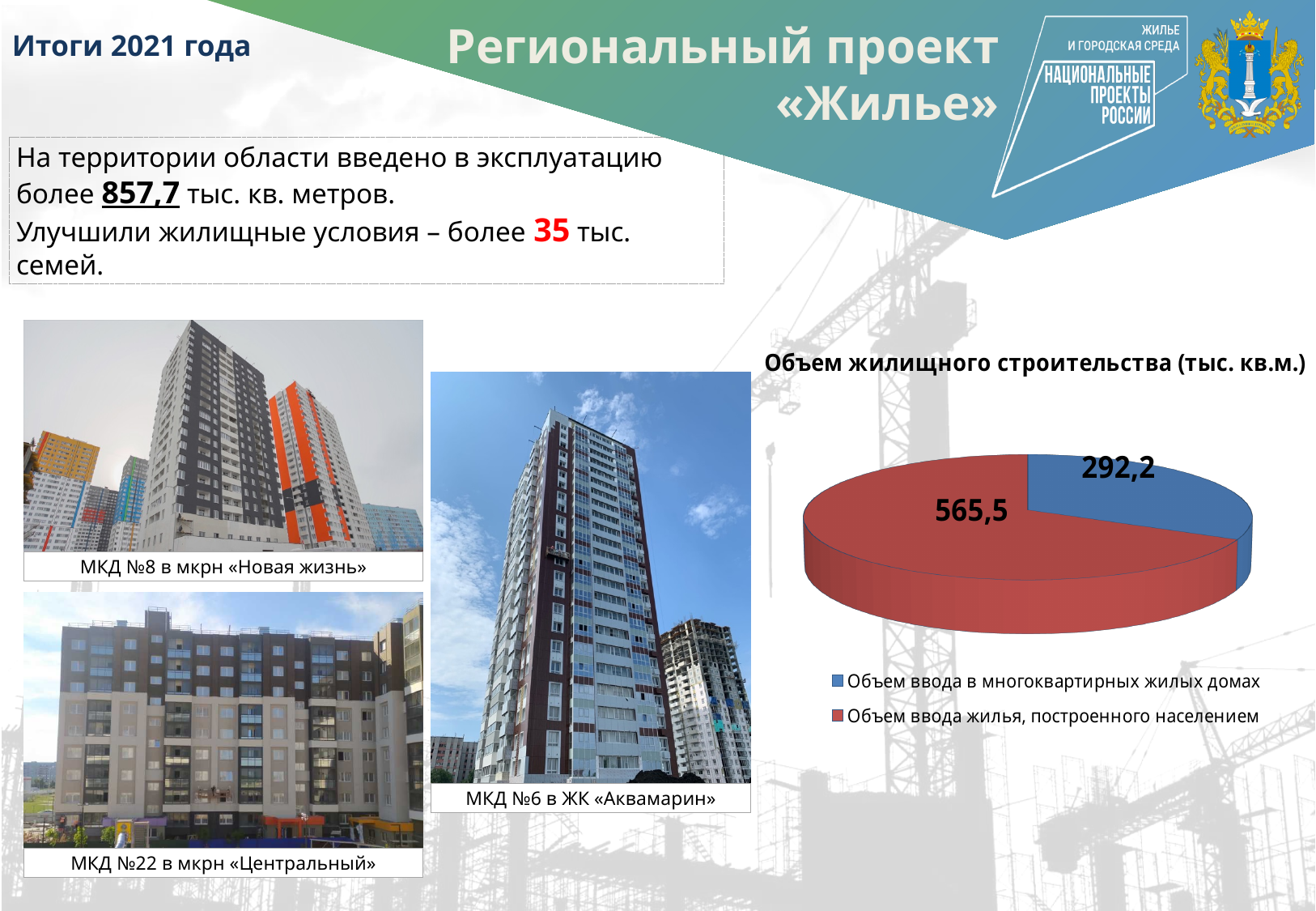
Which colour represents «Объем ввода жилья, построенного населением» in the pie chart? Red What is the total of the two values shown in the pie chart? 857,7 Which category has the smallest slice of the pie? Объем ввода в многоквартирных жилых домах What type of chart is shown on the slide? Pie chart How many entries does the chart legend list? 2 Which is larger: the value for «Объем ввода в многоквартирных жилых домах» or the value for «Объем ввода жилья, построенного населением»? Объем ввода жилья, построенного населением How many slices does the pie chart have? 2 What is the value for «Объем ввода жилья, построенного населением»? 565,5 Which category has the largest slice of the pie? Объем ввода жилья, построенного населением What is the value for «Объем ввода в многоквартирных жилых домах»? 292,2 What is the title of the chart? Объем жилищного строительства (тыс. кв.м.) What is the difference between the value for housing built by the population (565,5) and the value for apartment buildings (292,2)? 273,3